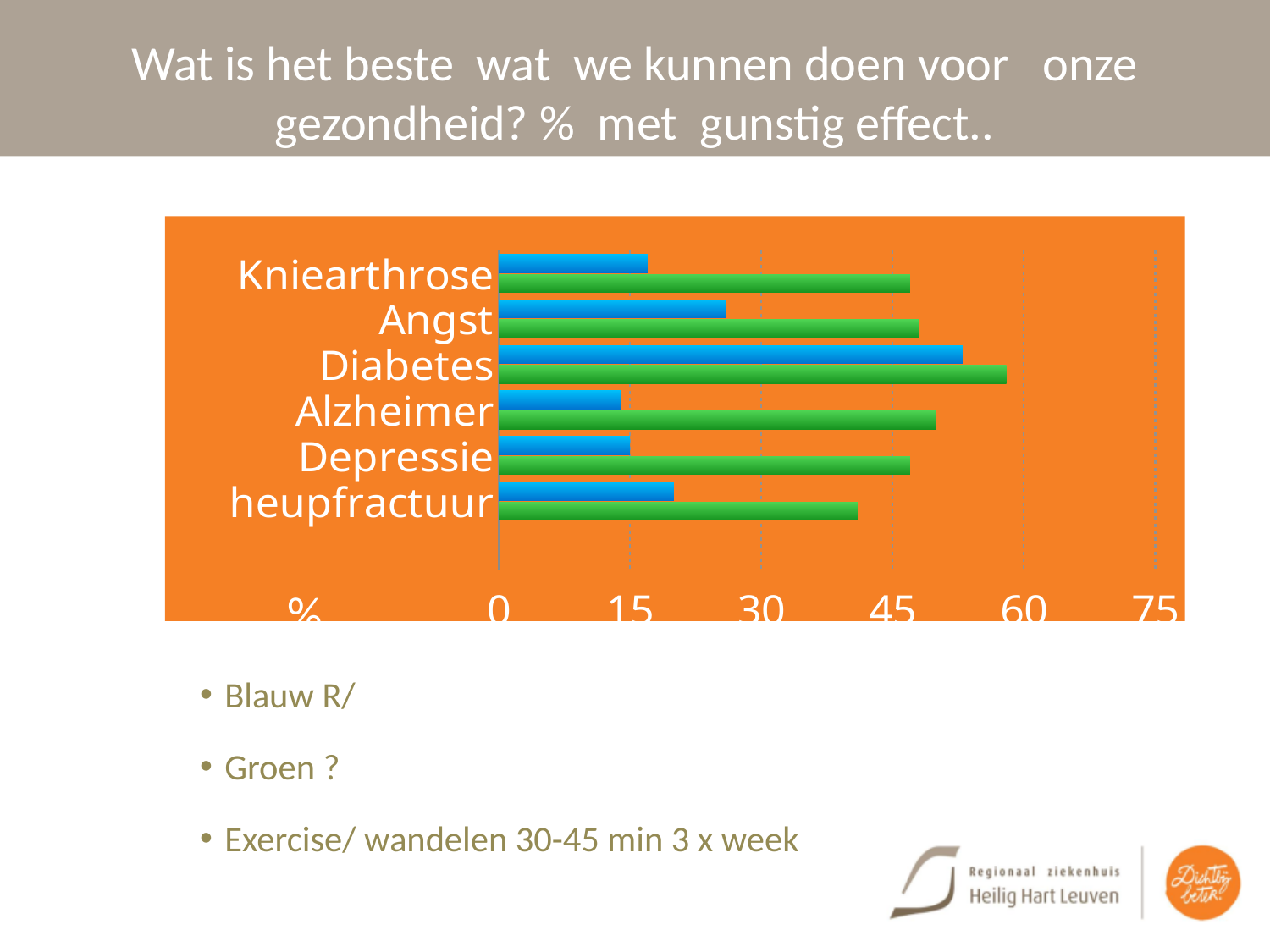
Is the blue bar for Angst greater or less than 30? less Which is larger, the blue bar for Diabetes or the blue bar for Angst? Diabetes Is the blue bar for Diabetes greater or less than 45? greater How many categories are shown on the chart? 6 Which category has the longest blue bar? Diabetes For Alzheimer, which bar is longer, the blue one or the green one? green What label is shown on the horizontal axis of the chart? % Is the green bar for heupfractuur greater or less than 45? less What kind of chart is shown on the slide? bar chart Which category has the longest green bar? Diabetes Which category has the shortest green bar? heupfractuur